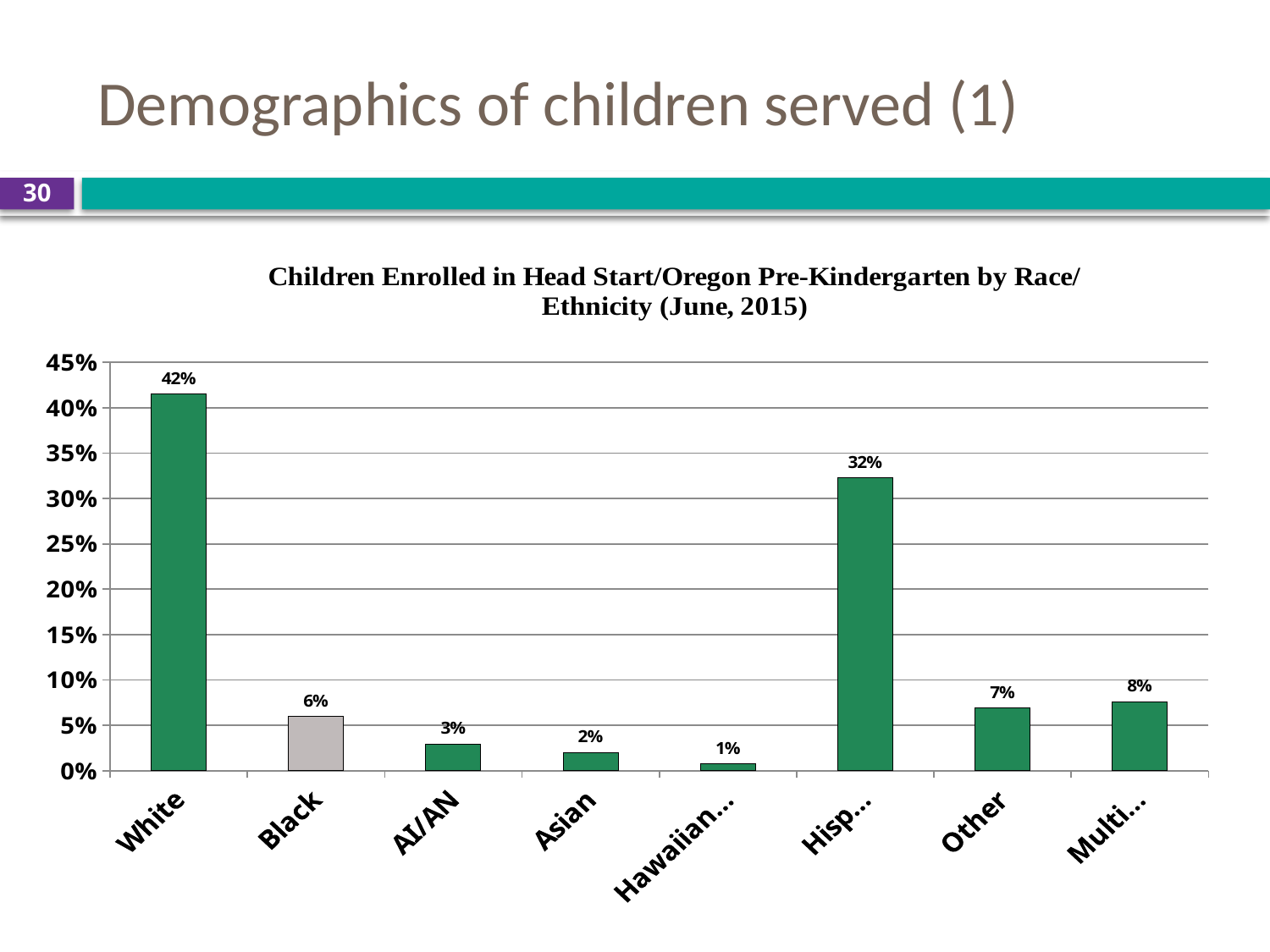
Which is larger, the value for Other or the value for Black? Other What is the value shown for AI/AN? 3% How many categories are shown on the x axis? 8 What is the value shown for Black? 6% What kind of chart is shown on the slide? bar chart What is the value shown for Other? 7% Which bar is coloured differently (grey) from the others? Black Which category has the lowest value? Hawaiian... Is the value for White greater or less than 40%? greater What percentage of children enrolled are White? 42% Which category has the highest value? White What is the difference between the values for White and Asian? 40%